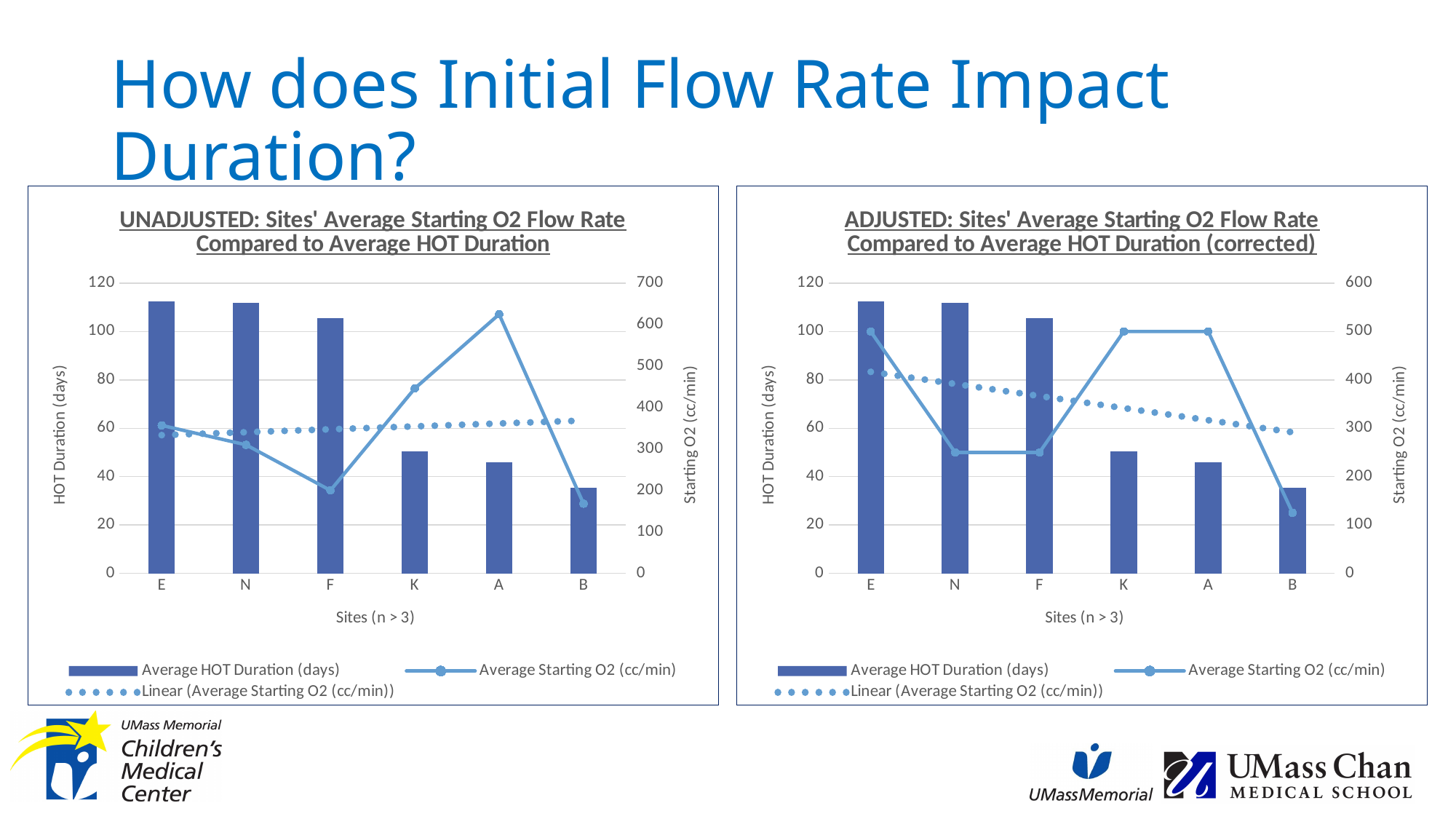
In the UNADJUSTED chart, which site has the larger Average Starting O2 (cc/min), K or N? K In the ADJUSTED chart, does the Linear (Average Starting O2 (cc/min)) trendline rise or fall from site E to site B? fall In the UNADJUSTED chart, is the Average HOT Duration (days) for site K greater or less than 60? less In the ADJUSTED chart, is the Average Starting O2 (cc/min) for site B greater or less than 200? less In the ADJUSTED chart, what is the Average Starting O2 (cc/min) for site K? 500 In the UNADJUSTED chart, which site has the lowest Average Starting O2 (cc/min)? B In the UNADJUSTED chart, is the Average Starting O2 (cc/min) for site A greater or less than 500? greater In the ADJUSTED chart, how many series does the legend list? 3 What kind of chart is the UNADJUSTED chart on the left? bar and line chart In the UNADJUSTED chart, how many sites are shown on the x axis? 6 In the UNADJUSTED chart, which site has the highest Average Starting O2 (cc/min)? A In the UNADJUSTED chart, which site has the lowest Average HOT Duration (days)? B